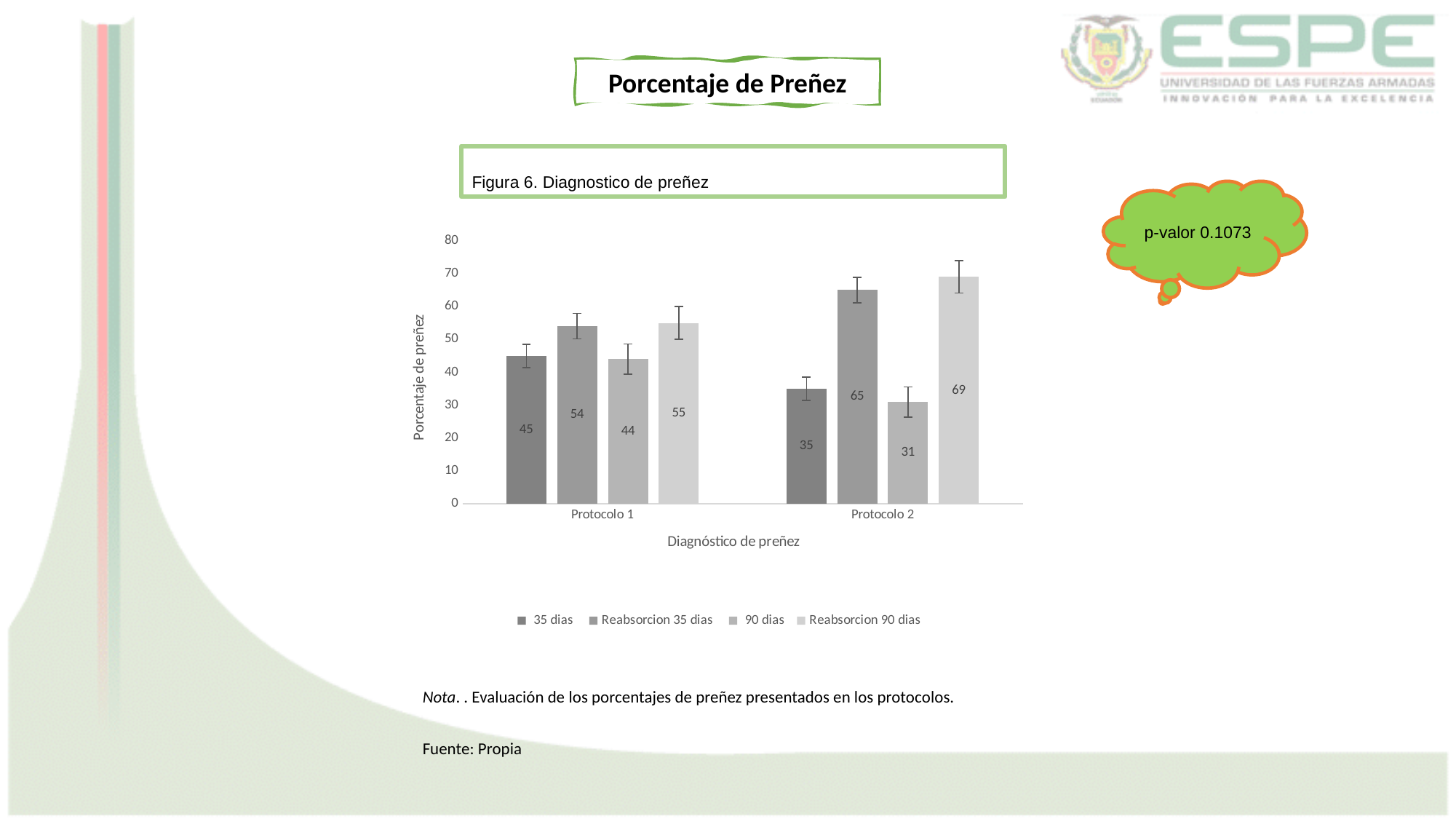
Which is larger: the 35 dias value for Protocolo 1 or for Protocolo 2? Protocolo 1 What type of chart is shown on the slide? Bar chart What is the value for 35 dias in Protocolo 1? 45 What is the value for Reabsorcion 90 dias in Protocolo 2? 69 How many categories are shown on the x axis? 2 What is the value for 90 dias in Protocolo 2? 31 Which series has the lowest value in Protocolo 2? 90 dias Which series has the highest value in Protocolo 2? Reabsorcion 90 dias What is the difference between Reabsorcion 35 dias in Protocolo 2 and Reabsorcion 35 dias in Protocolo 1? 11 Is the value for Reabsorcion 35 dias in Protocolo 2 greater or less than 60? greater What is the title of the y axis? Porcentaje de preñez How many series does the legend list? 4